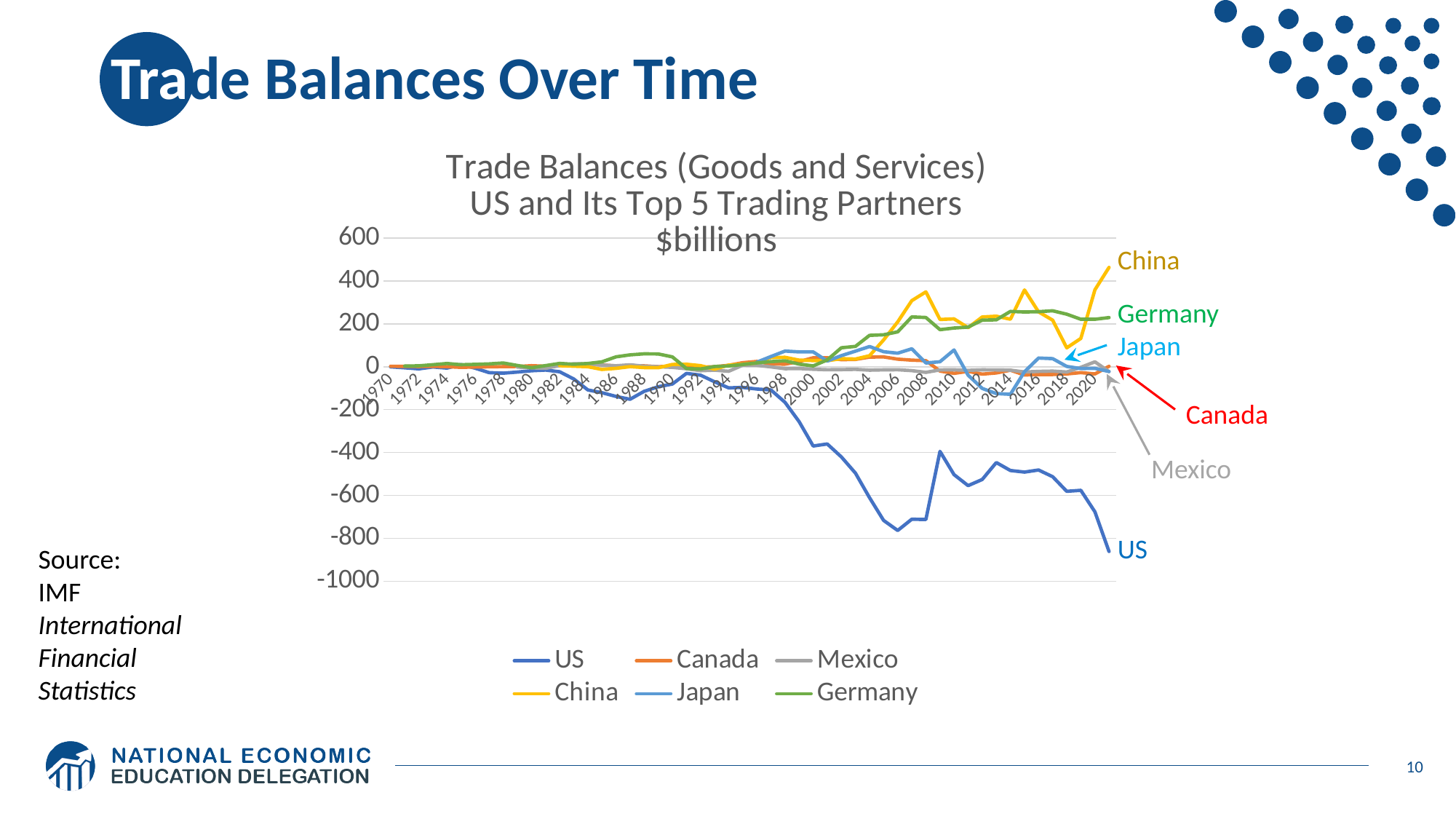
What kind of chart is shown on the slide? line chart Is the value for Germany in 2020 greater or less than 200? greater Which series has the highest value in 2020? China How many series does the legend list? 6 Which series are listed in the chart legend? US, Canada, Mexico, China, Japan, Germany What is the title of the chart? Trade Balances (Goods and Services) US and Its Top 5 Trading Partners $billions In 2020, which is larger, the value for China or the value for Germany? China Is the value for the US in 2006 greater or less than -600? less Which series has the lowest value in 2020? US Does the US trade balance generally rise or fall from 1970 to 2020? fall